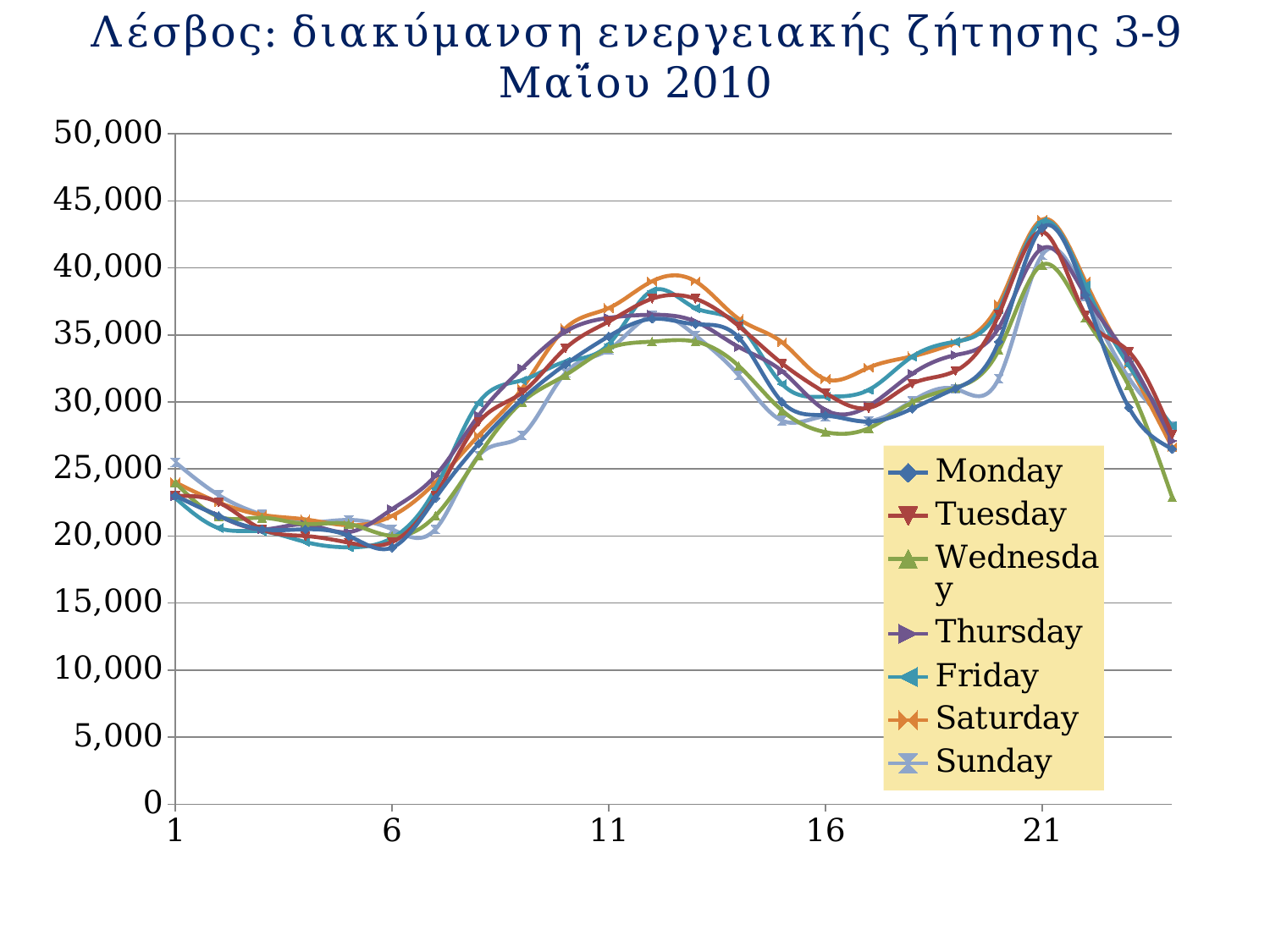
Is the value for Saturday at hour 12 greater or less than 35,000? greater Which series is listed last in the legend? Sunday Is the value for Wednesday at hour 24 greater or less than 25,000? less Which series has the lowest value at hour 24? Wednesday Is the value for Saturday at hour 21 greater or less than 40,000? greater Which series is listed first in the legend? Monday How many series does the legend list? 7 What kind of chart is shown on the slide? line chart Do the values rise or fall between hour 6 and hour 12? rise Do the values rise or fall between hour 21 and hour 24? fall